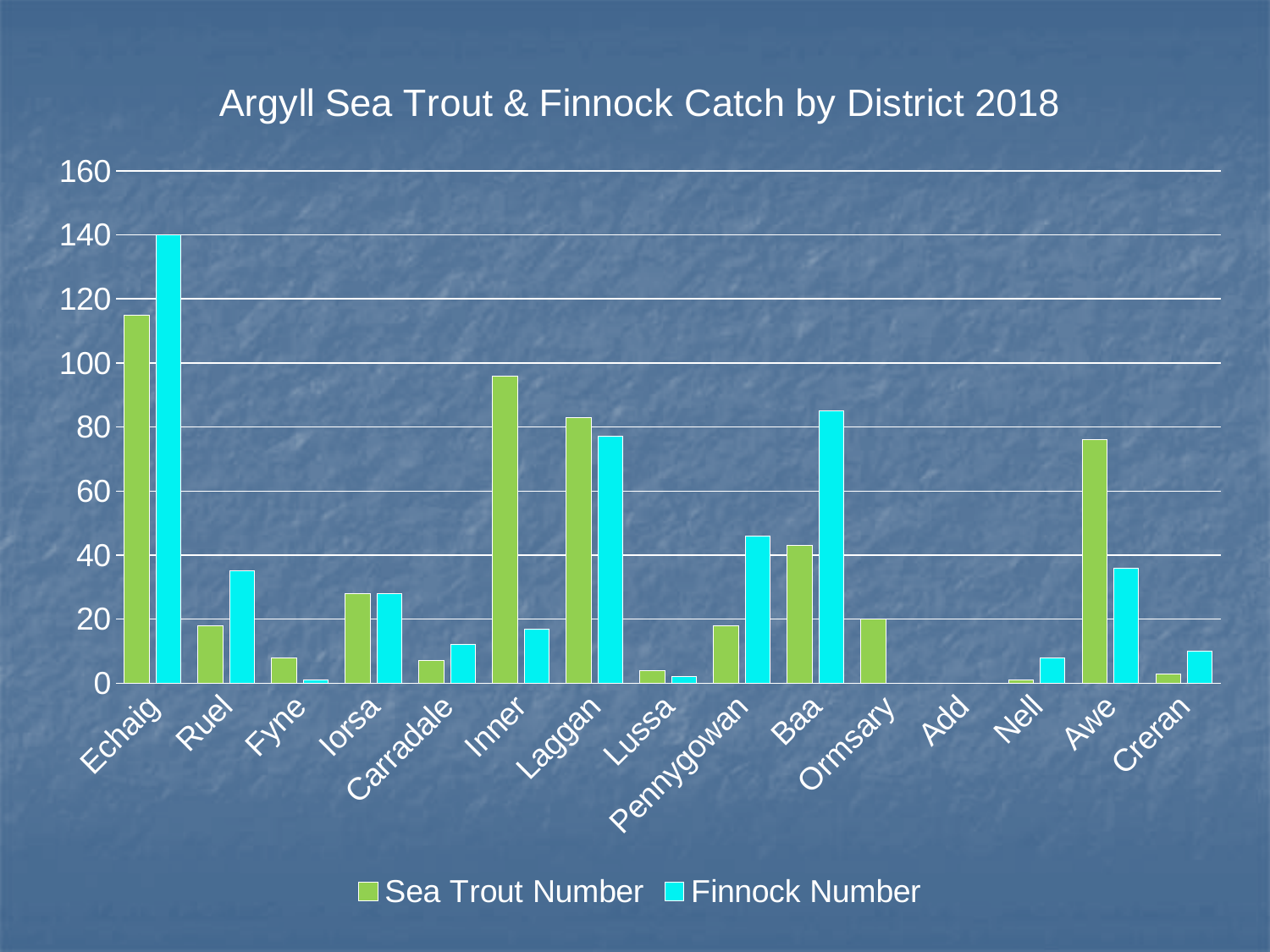
For Baa, which is larger: the Sea Trout Number or the Finnock Number? Finnock Number What kind of chart is shown on the slide? bar chart How many districts are shown on the x axis? 15 What is the title of the chart? Argyll Sea Trout & Finnock Catch by District 2018 For Inner, which is larger: the Sea Trout Number or the Finnock Number? Sea Trout Number Is the Sea Trout Number for Inner greater or less than 80? greater What is the Finnock Number for Echaig? 140 Is the Finnock Number for Pennygowan greater or less than 40? greater How many series does the legend list? 2 Which district has the highest Finnock Number? Echaig Is the Finnock Number for Ruel greater or less than 40? less Which district has the highest Sea Trout Number? Echaig